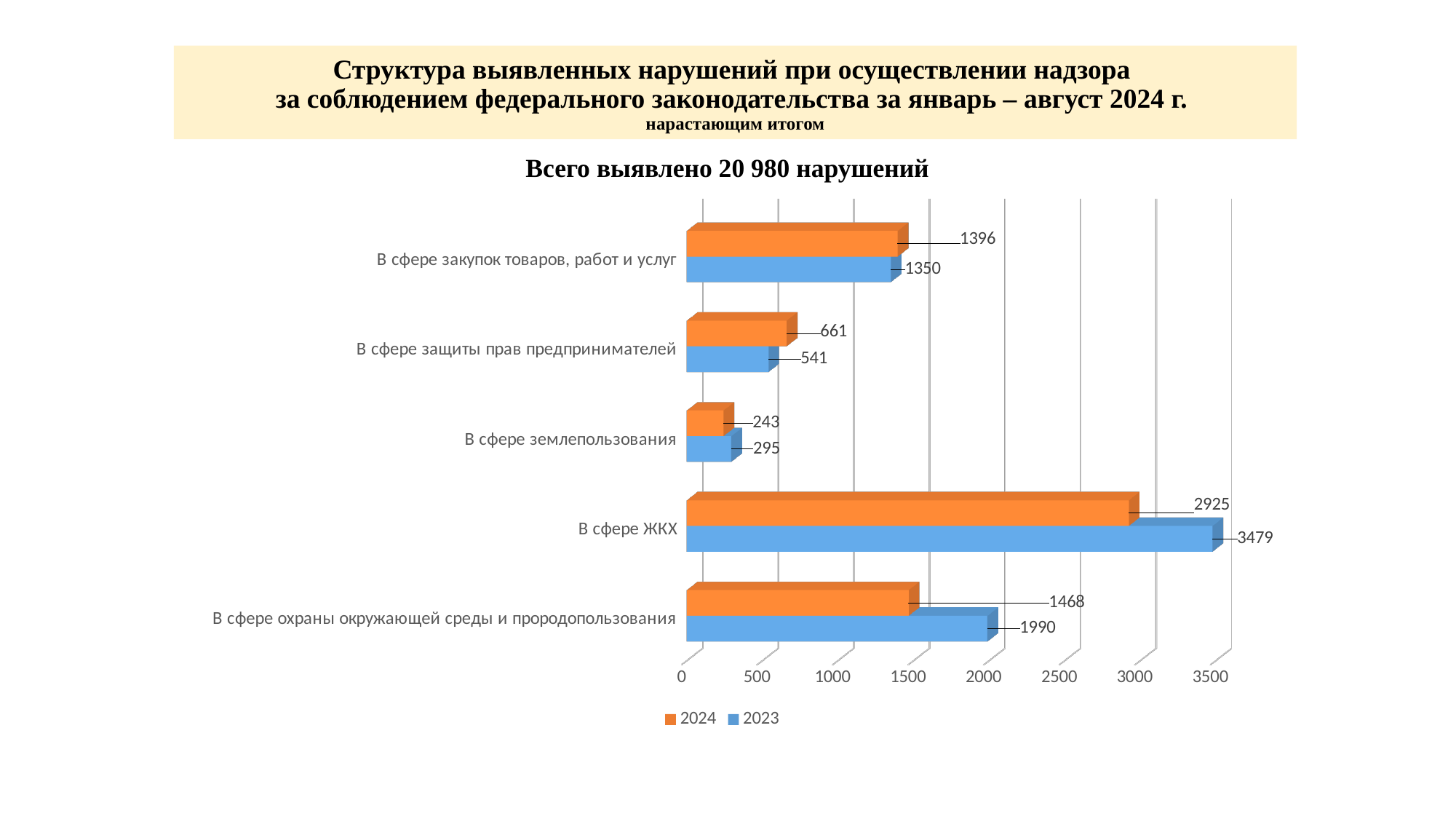
What is the 2023 value for «В сфере охраны окружающей среды и прородопользования»? 1990 What is the difference between the 2023 and 2024 values for «В сфере ЖКХ»? 554 Which colour represents the 2023 series in the legend? Blue How many series does the legend list? 2 Which is larger for «В сфере закупок товаров, работ и услуг»: the 2024 value or the 2023 value? 2024 What kind of chart is shown on the slide? Bar chart Which category has the lowest 2024 value? В сфере землепользования What is the 2023 value for «В сфере землепользования»? 295 How many categories are shown on the chart? 5 What is the 2024 value for «В сфере защиты прав предпринимателей»? 661 Which category has the highest 2023 value? В сфере ЖКХ What is the 2024 value for «В сфере ЖКХ»? 2925